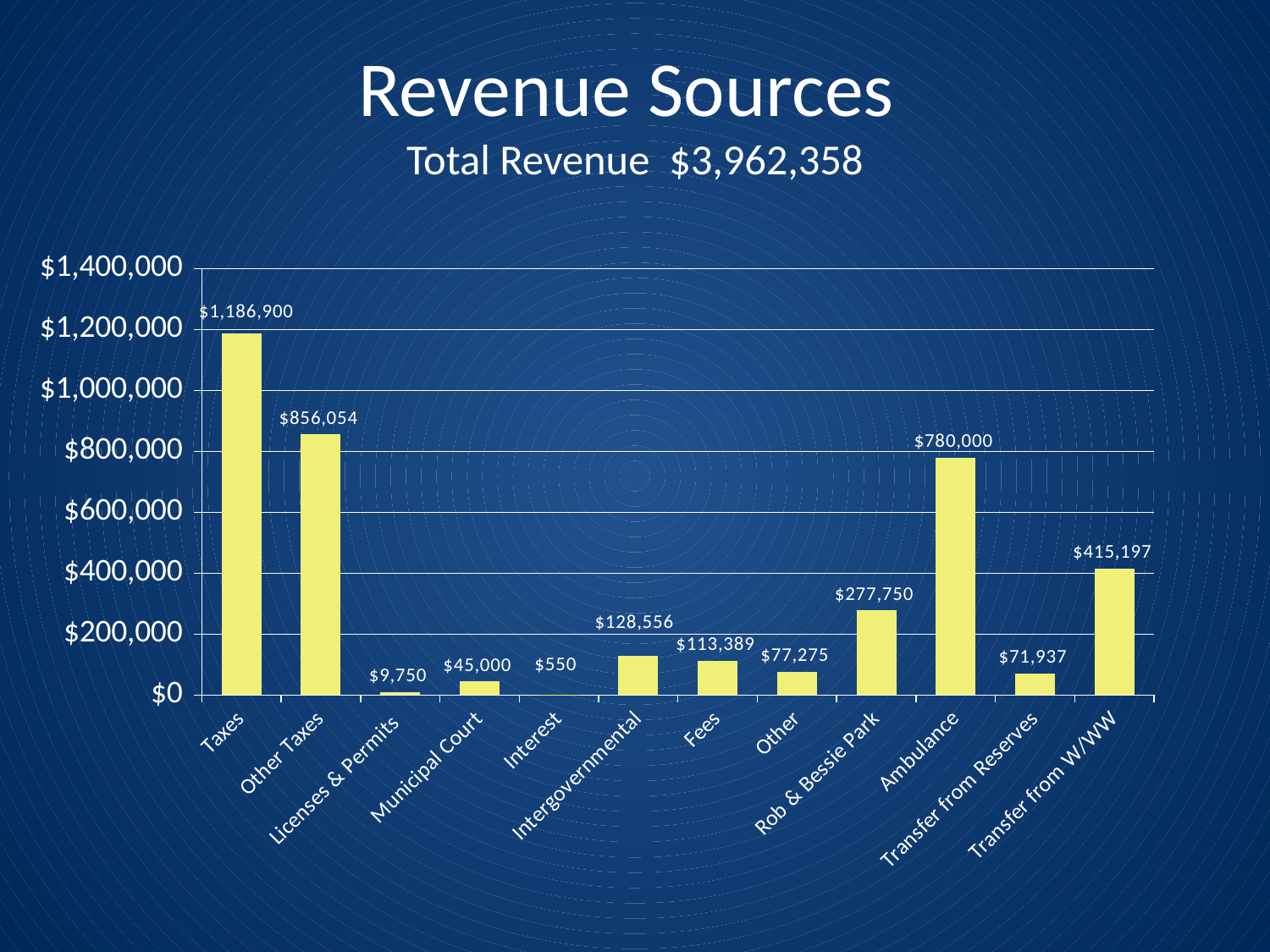
Which category has the highest value? Taxes Which category has the lowest value? Interest How many categories are shown on the x axis? 12 Is the value for Rob & Bessie Park greater or less than $200,000? greater What kind of chart is shown? bar chart What is the difference between Taxes and Other Taxes? $330,846 What is the value for Interest? $550 What total revenue is stated in the slide subtitle? $3,962,358 What is the value for Taxes? $1,186,900 What is the value for Transfer from W/WW? $415,197 Which is larger, Fees or Intergovernmental? Intergovernmental What is the value for Ambulance? $780,000